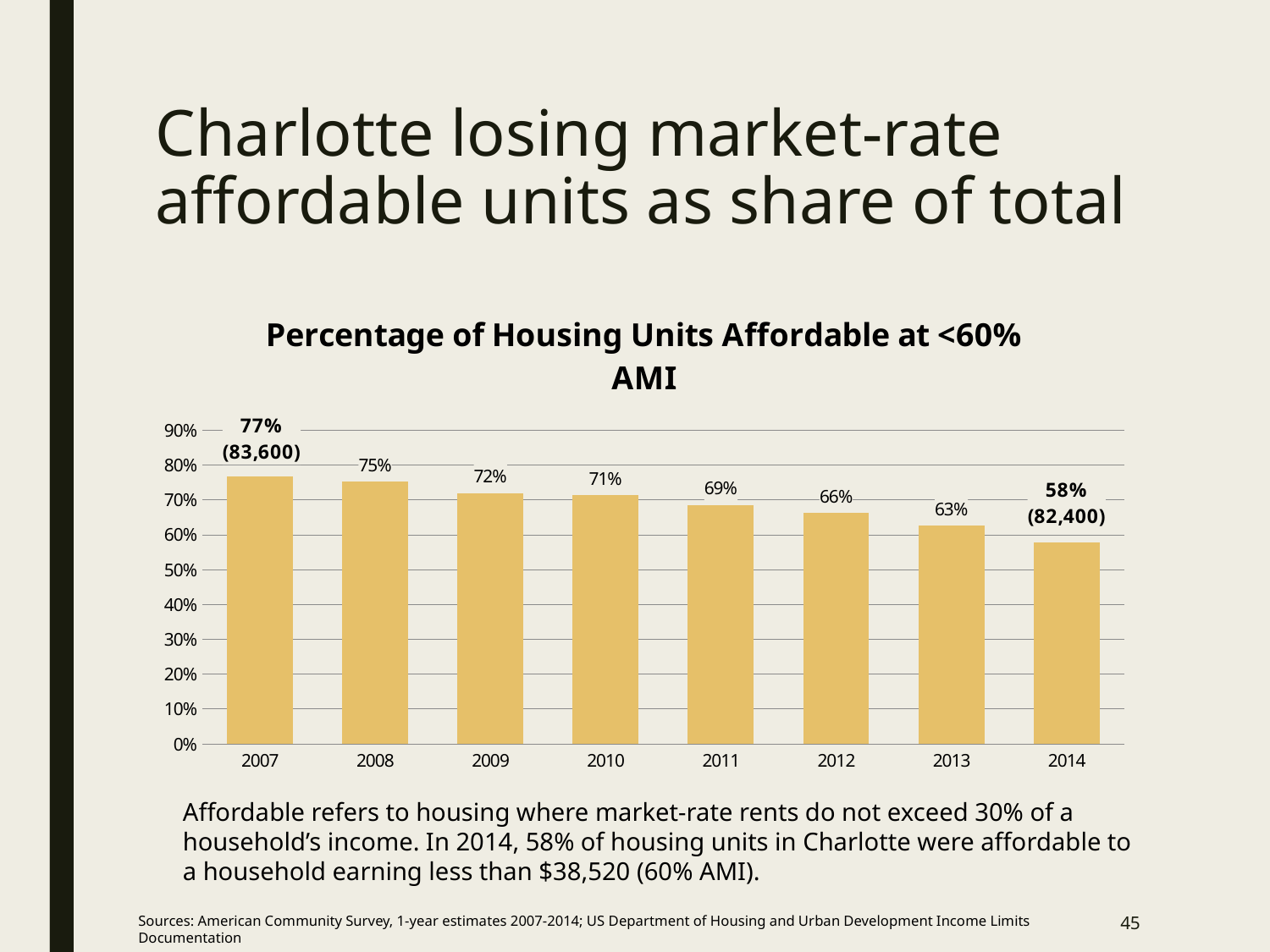
Which is larger, the value for 2009 or the value for 2012? 2009 How many years are shown on the x axis? 8 What is the title of the chart? Percentage of Housing Units Affordable at <60% AMI Which year has the lowest percentage of housing units affordable at <60% AMI? 2014 Which year has the highest percentage of housing units affordable at <60% AMI? 2007 What is the difference between the values for 2007 and 2014? 19% What is the value for 2007? 77% Do the values rise or fall from 2007 to 2014? fall What kind of chart is shown on the slide? bar chart Is the value for 2013 greater or less than 60%? greater What is the value for 2011? 69% What is the value for 2014? 58%